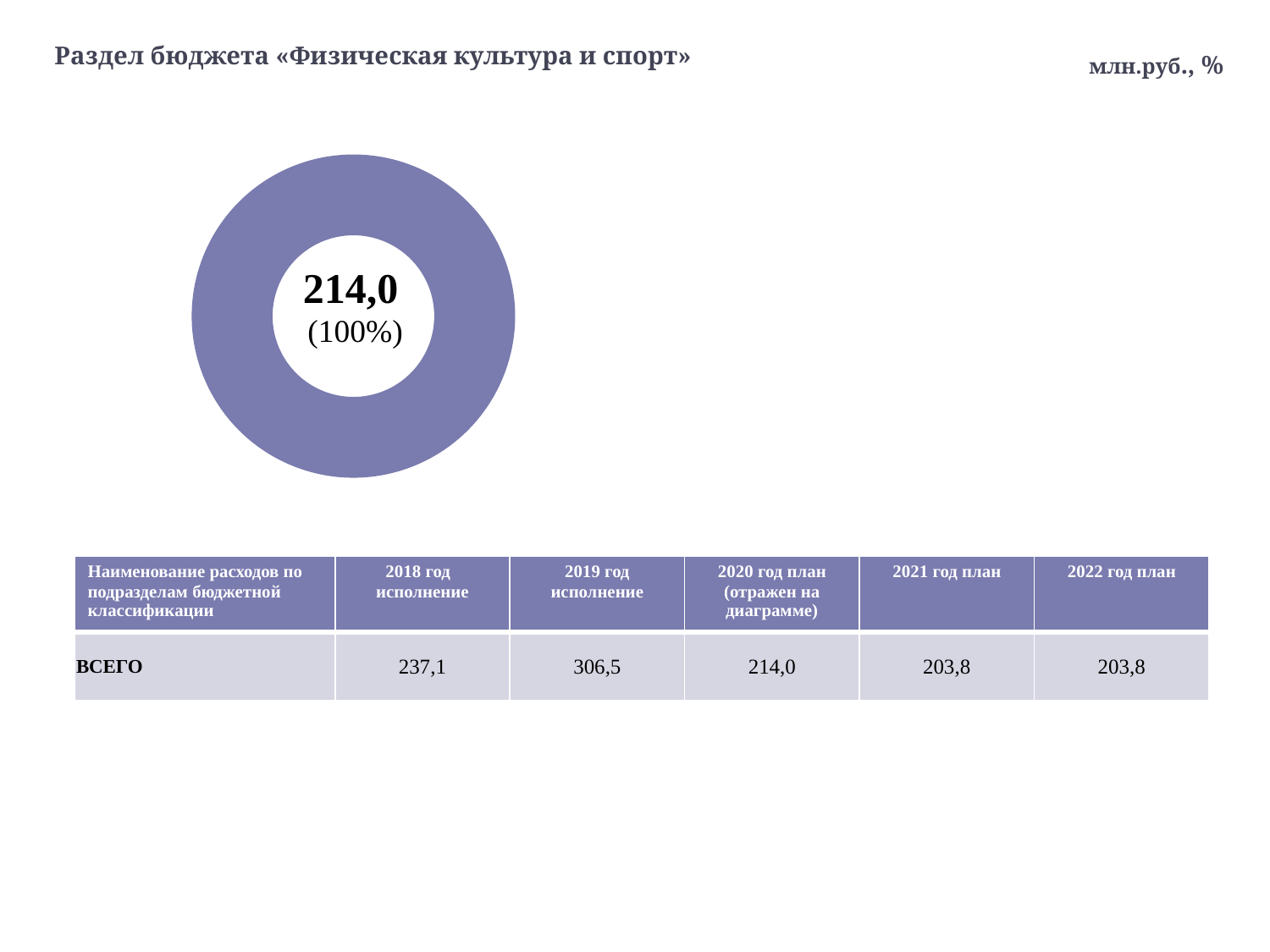
What value is printed in the centre of the donut chart? 214,0 Which year's figure does the donut chart reflect, according to the table header? 2020 год план What units are indicated for the chart in the top-right corner of the slide? млн.руб., % How many slices does the donut chart contain? 1 What share of the donut chart does the single slice represent? 100% What kind of chart is shown on the slide? Pie chart (donut)